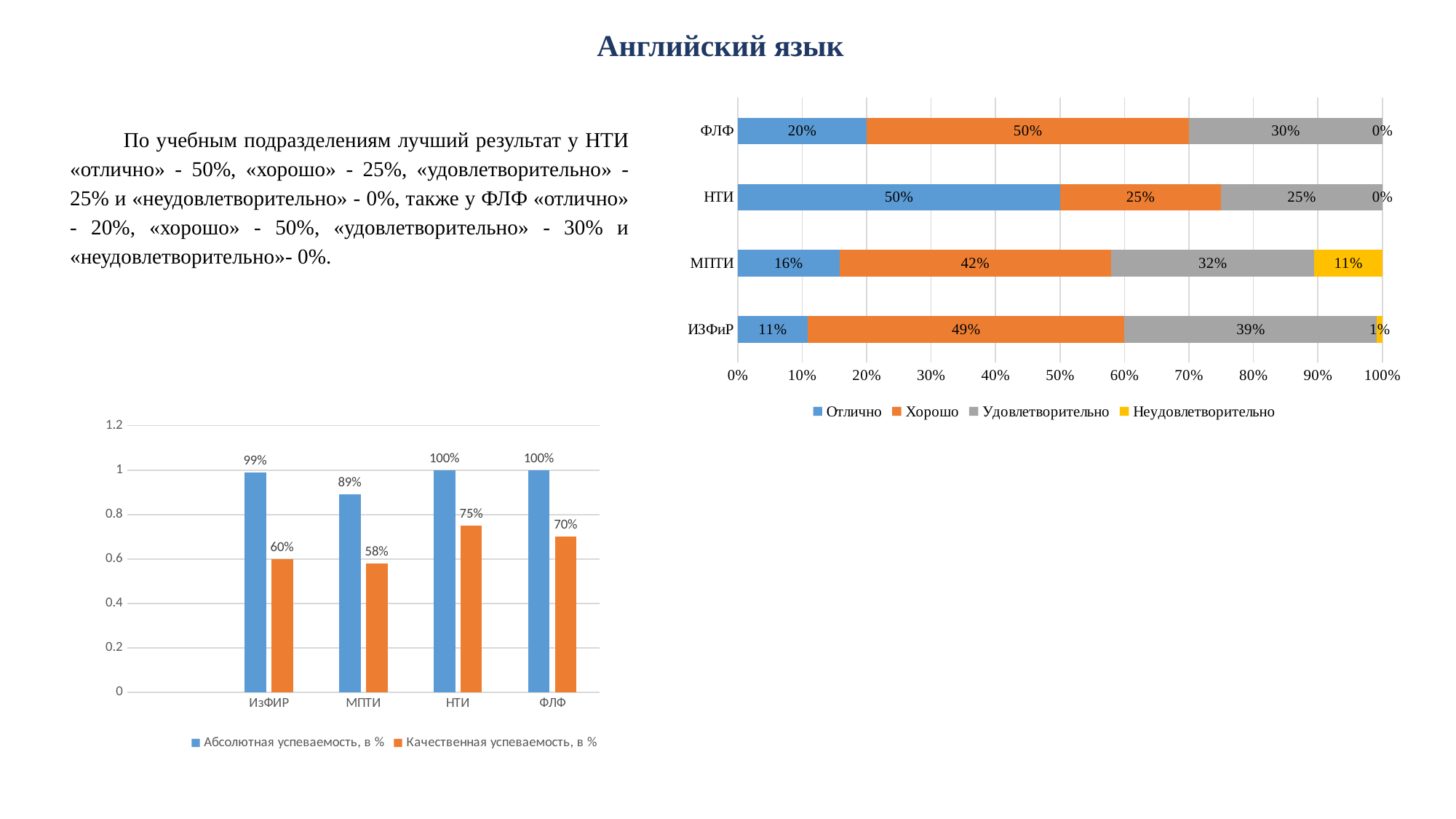
In the stacked bar chart on the right, what is the value for «Неудовлетворительно» for МПТИ? 11% In the stacked bar chart on the right, what is the difference between the «Удовлетворительно» values for ИЗФиР and ФЛФ? 9% In the stacked bar chart on the right, which department has the highest «Отлично» share? НТИ In the bar chart at the bottom left, what is the value of «Абсолютная успеваемость, в %» for МПТИ? 89% In the stacked bar chart on the right, what is the value for «Хорошо» for ФЛФ? 50% In the stacked bar chart on the right, how many series does the legend list? 4 In the stacked bar chart on the right, which department has the lowest «Отлично» share? ИЗФиР In the bar chart at the bottom left, is «Качественная успеваемость, в %» for ИзФИР larger than for ФЛФ? No In the stacked bar chart on the right, what is the value for «Отлично» for НТИ? 50% In the bar chart at the bottom left, which category has the lowest «Качественная успеваемость, в %»? МПТИ In the bar chart at the bottom left, how many categories are shown on the x axis? 4 In the bar chart at the bottom left, what is the value of «Качественная успеваемость, в %» for НТИ? 75%